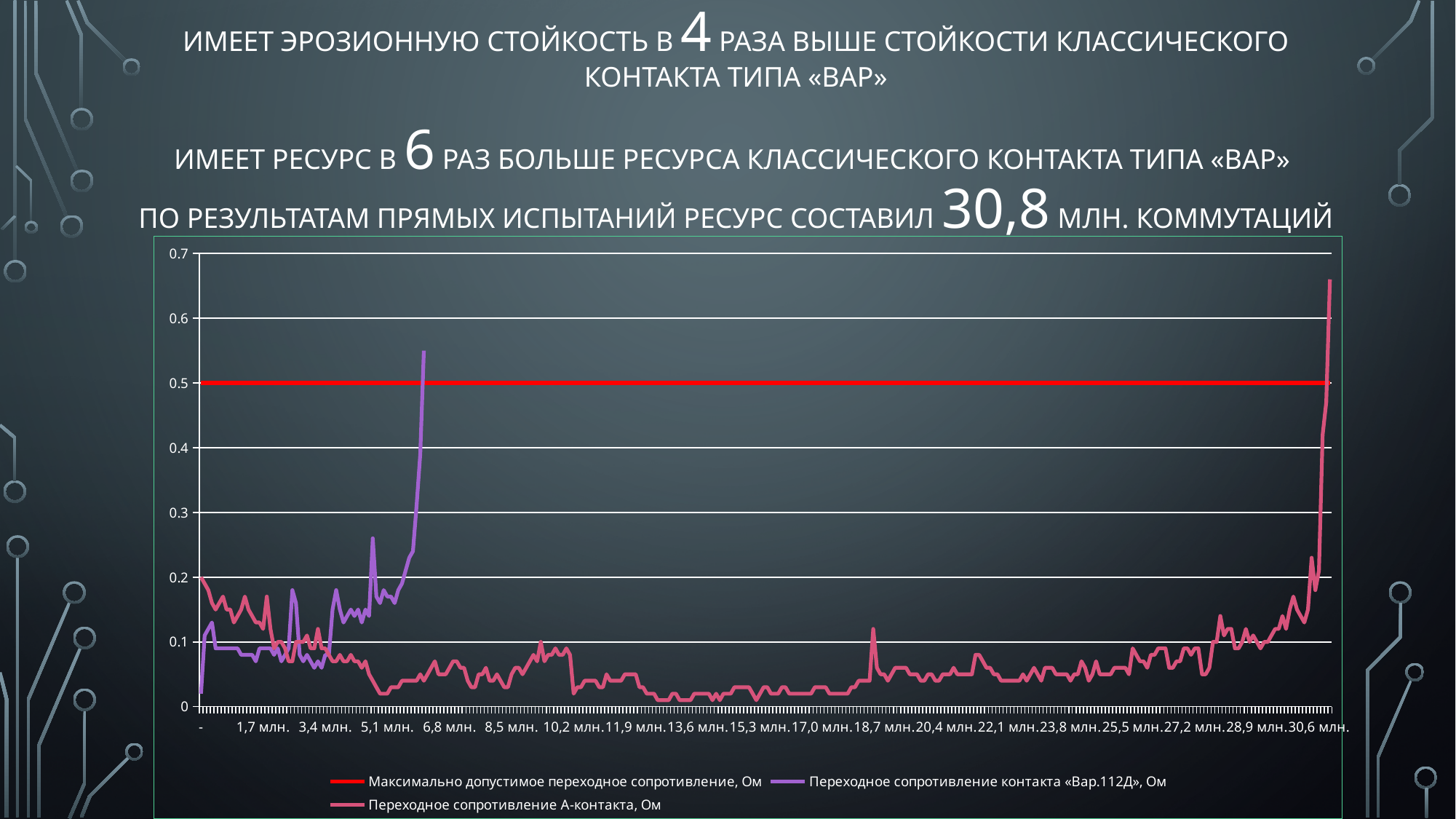
What is the highest tick value shown on the y axis? 0.7 At what value does the red line "Максимально допустимое переходное сопротивление, Ом" run across the chart? 0.5 What colour is the line for "Переходное сопротивление контакта «Вар.112Д», Ом"? purple What kind of chart is shown on the slide? line chart Which series reaches the higher maximum value: "Переходное сопротивление контакта «Вар.112Д», Ом" or "Переходное сопротивление А-контакта, Ом"? Переходное сопротивление А-контакта, Ом Which series extends furthest along the x axis? Переходное сопротивление А-контакта, Ом Is the final value of the pink series "Переходное сопротивление А-контакта, Ом" at the right end of the chart greater or less than 0.6? greater Does the pink series "Переходное сопротивление А-контакта, Ом" rise or fall toward the right end of the x axis? rise How many series does the chart legend list? 3 What is the last label shown on the x axis? 30,6 млн. Is the peak value of the purple series "Переходное сопротивление контакта «Вар.112Д», Ом" greater or less than 0.5? greater Is the value of the pink series "Переходное сопротивление А-контакта, Ом" around 15,3 млн. greater or less than 0.1? less